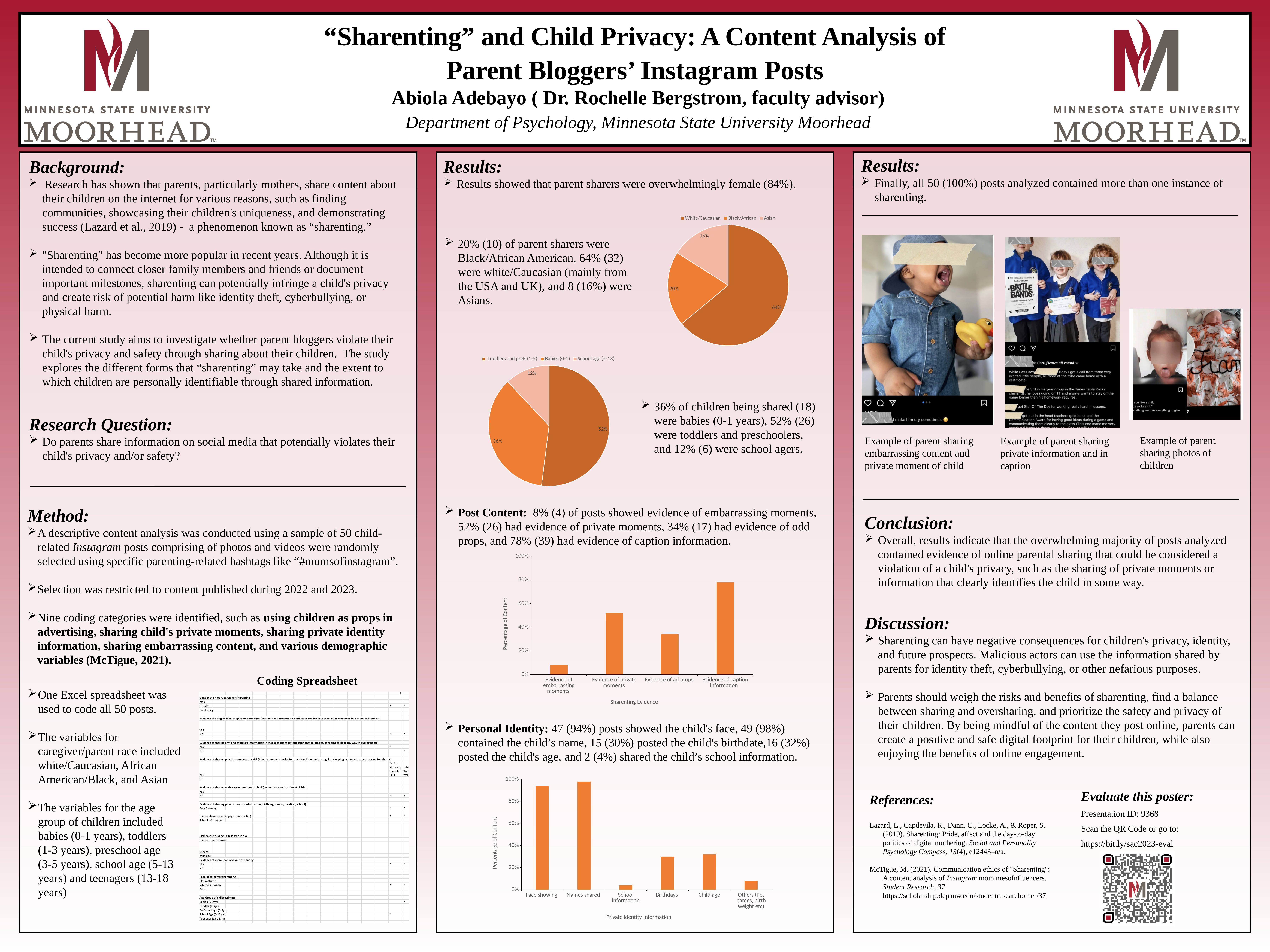
In the top pie chart on the race of parent sharers, what percentage is White/Caucasian? 64% What kind of chart is the chart with the x-axis labelled 'Sharenting Evidence'? Bar chart In the top pie chart on the race of parent sharers, which category has the largest share? White/Caucasian How many categories does the legend of the second pie chart on children's age groups list? 3 In the bar chart with the x-axis 'Sharenting Evidence', is the value for Evidence of private moments greater or less than 40%? greater How many categories are shown on the x-axis of the bar chart labelled 'Private Identity Information'? 6 In the top pie chart on the race of parent sharers, what percentage is Asian? 16% In the top pie chart on the race of parent sharers, how many percentage points larger is the White/Caucasian share than the Black/African share? 44 percentage points In the second pie chart on children's age groups, which category has the smallest share? School age (5-13) In the bar chart with the x-axis 'Private Identity Information', which category has the lowest percentage? School information In the bar chart with the x-axis 'Sharenting Evidence', which category has the highest percentage? Evidence of caption information In the second pie chart on children's age groups, what percentage is Babies (0-1)? 36%